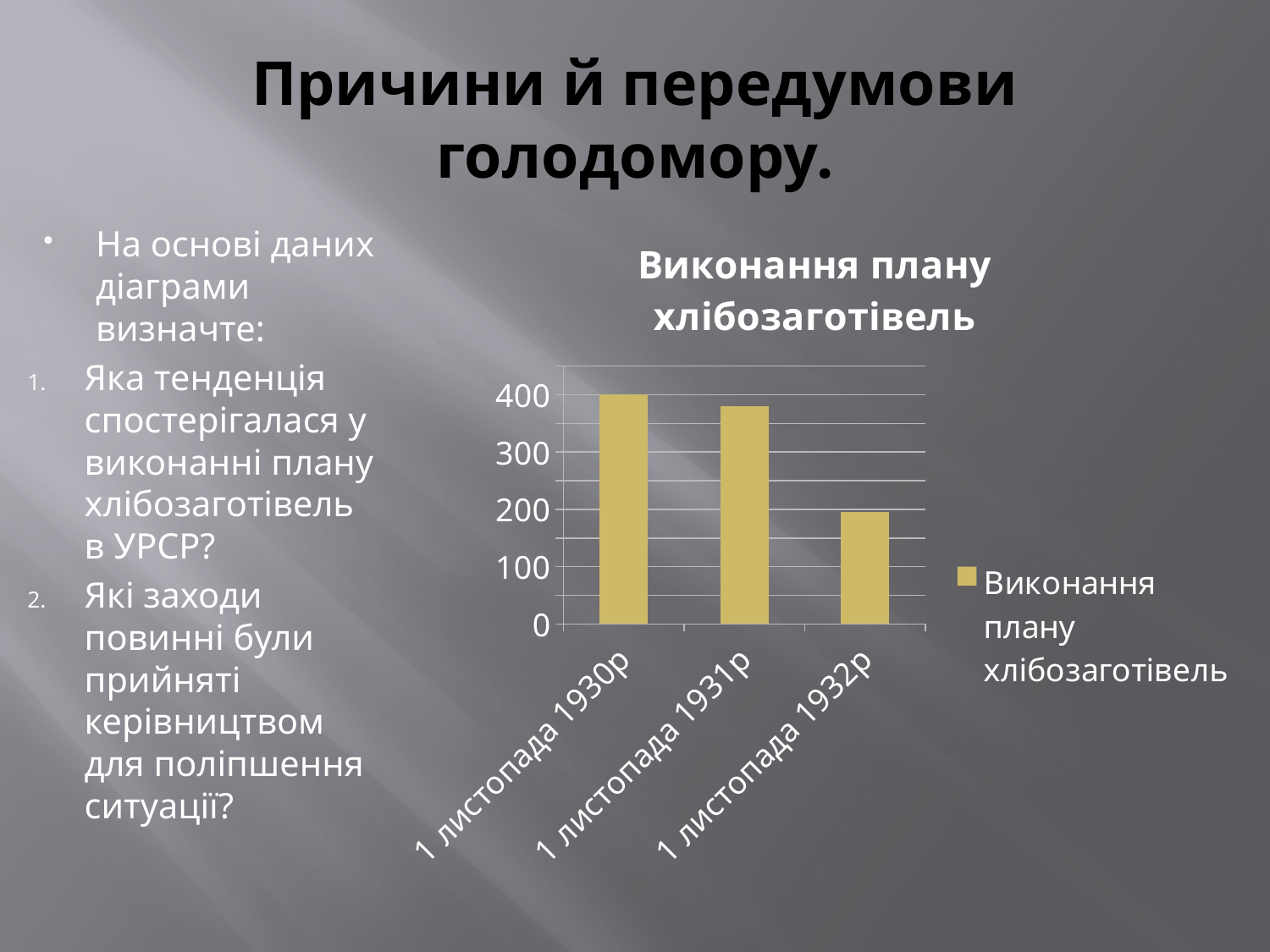
What is the legend entry of the chart? Виконання плану хлібозаготівель Which category has the lowest value? 1 листопада 1932р Is the value for 1 листопада 1932р greater or less than 300? less Which is larger, the value for 1 листопада 1930р or for 1 листопада 1932р? 1 листопада 1930р How many categories (bars) does the chart show? 3 Which category has the highest value? 1 листопада 1930р How many series does the legend list? 1 Is the value for 1 листопада 1930р greater or less than 300? greater Do the values rise or fall from 1 листопада 1930р to 1 листопада 1932р? fall What kind of chart is shown on the slide? bar chart What is the title of the chart? Виконання плану хлібозаготівель Is the value for 1 листопада 1931р greater or less than 300? greater